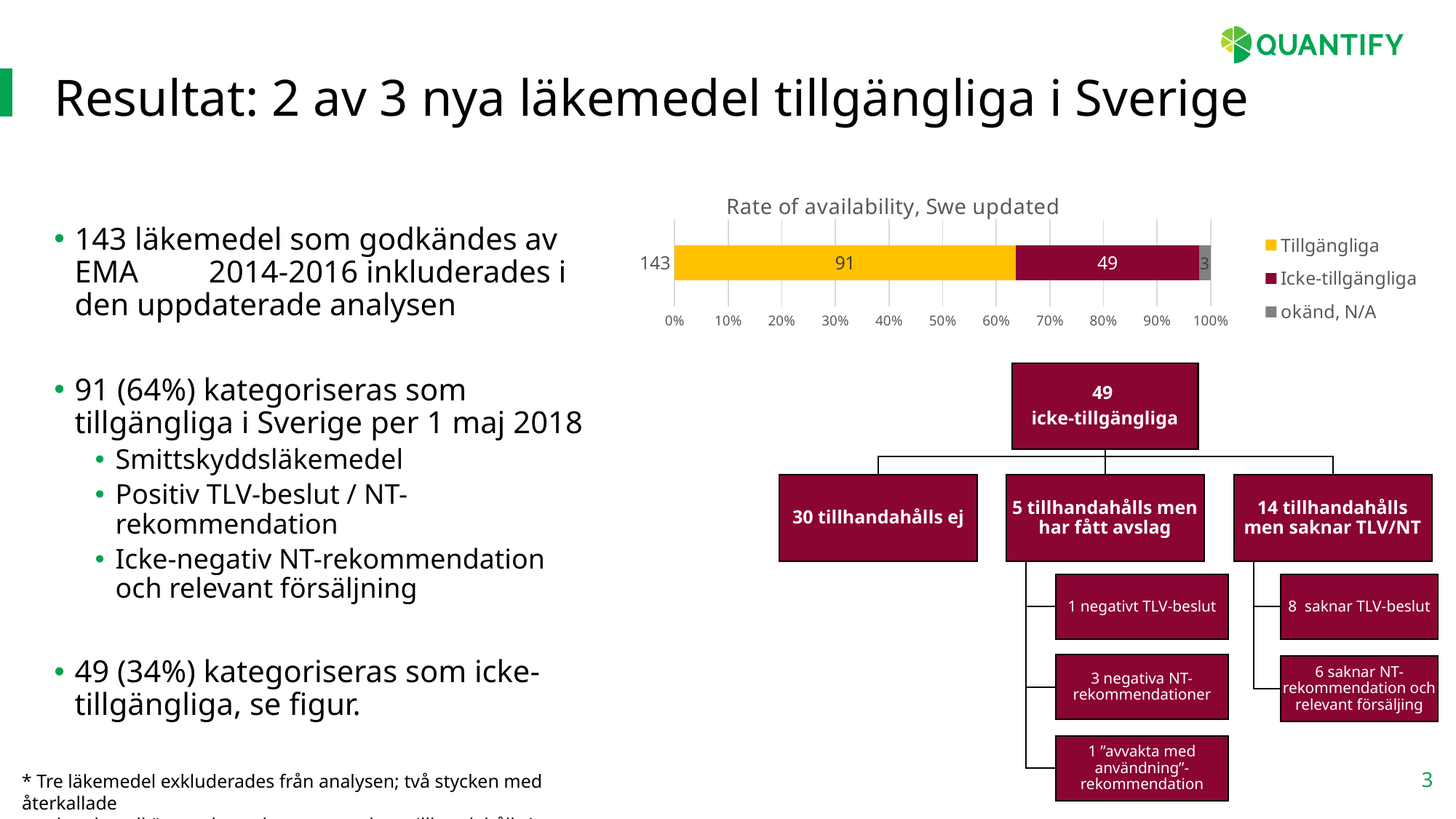
Which series has the largest segment in the chart? Tillgängliga What kind of chart is shown on the slide? stacked bar chart Which colour represents Tillgängliga in the chart? yellow What is the difference between the Tillgängliga and Icke-tillgängliga values in the chart? 42 How many series does the chart legend list? 3 What is the total of the stacked bar in the chart? 143 Which is larger in the chart, Icke-tillgängliga or okänd, N/A? Icke-tillgängliga What is the value of the okänd, N/A segment in the chart? 3 What is the title of the chart? Rate of availability, Swe updated What is the value of the Icke-tillgängliga segment in the chart? 49 What is the value of the Tillgängliga segment in the chart? 91 Which series has the smallest segment in the chart? okänd, N/A